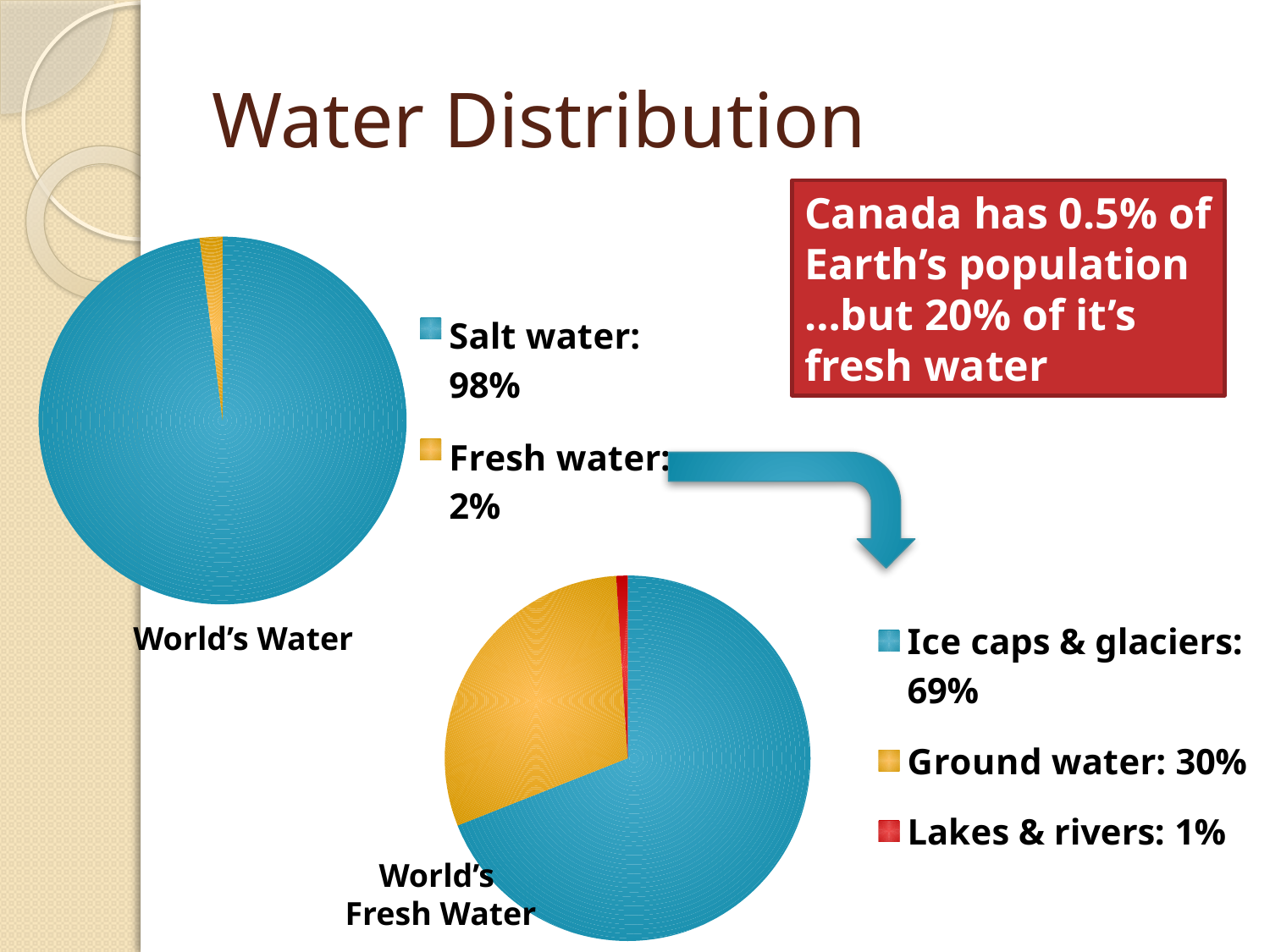
In the World's Water pie chart, what is the difference between the salt water and fresh water shares? 96% In the World's Fresh Water pie chart, what share is lakes & rivers? 1% In the World's Fresh Water pie chart, which category has the smallest share? Lakes & rivers In the World's Fresh Water pie chart, which category has the largest share? Ice caps & glaciers In the World's Water pie chart, what share is salt water? 98% How many categories does the World's Fresh Water pie chart show? 3 In the World's Fresh Water pie chart, which is larger, ground water or lakes & rivers? Ground water What type of chart is the World's Water chart? Pie chart In the World's Fresh Water pie chart, what share is ice caps & glaciers? 69% In the World's Fresh Water pie chart, what is the difference between the ice caps & glaciers share and the ground water share? 39%